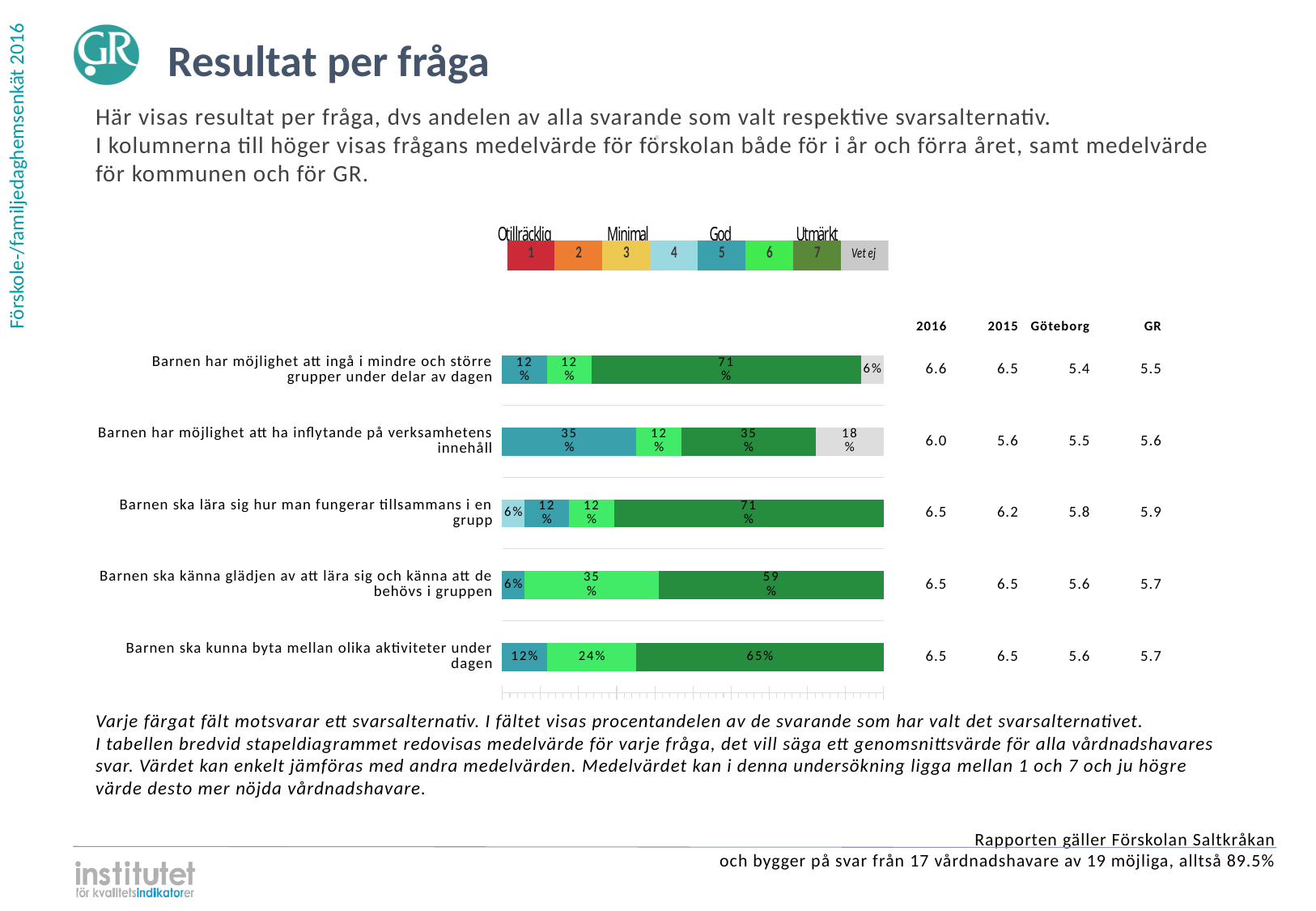
What is the light green segment percentage for "Barnen ska känna glädjen av att lära sig och känna att de behövs i gruppen"? 35% How many questions (categories) are shown in the bar chart? 5 What is the largest percentage segment in the bar for "Barnen ska kunna byta mellan olika aktiviteter under dagen"? 65% For "Barnen har möjlighet att ha inflytande på verksamhetens innehåll", how much higher is the 2016 mean than the 2015 mean? 0.4 What type of chart is used to show the share of respondents per answer option? Stacked bar chart What label does the legend give to the grey category after the 1–7 scale? Vet ej Which question has the lowest 2016 mean value? Barnen har möjlighet att ha inflytande på verksamhetens innehåll What is the 2015 mean value for "Barnen ska lära sig hur man fungerar tillsammans i en grupp"? 6.2 For "Barnen ska lära sig hur man fungerar tillsammans i en grupp", which is higher: the Göteborg mean or the GR mean? GR Which question has the highest 2016 mean value? Barnen har möjlighet att ingå i mindre och större grupper under delar av dagen What is the 2016 mean value for "Barnen har möjlighet att ingå i mindre och större grupper under delar av dagen"? 6.6 What percentage of respondents answered "Vet ej" (grey segment) for "Barnen har möjlighet att ha inflytande på verksamhetens innehåll"? 18%